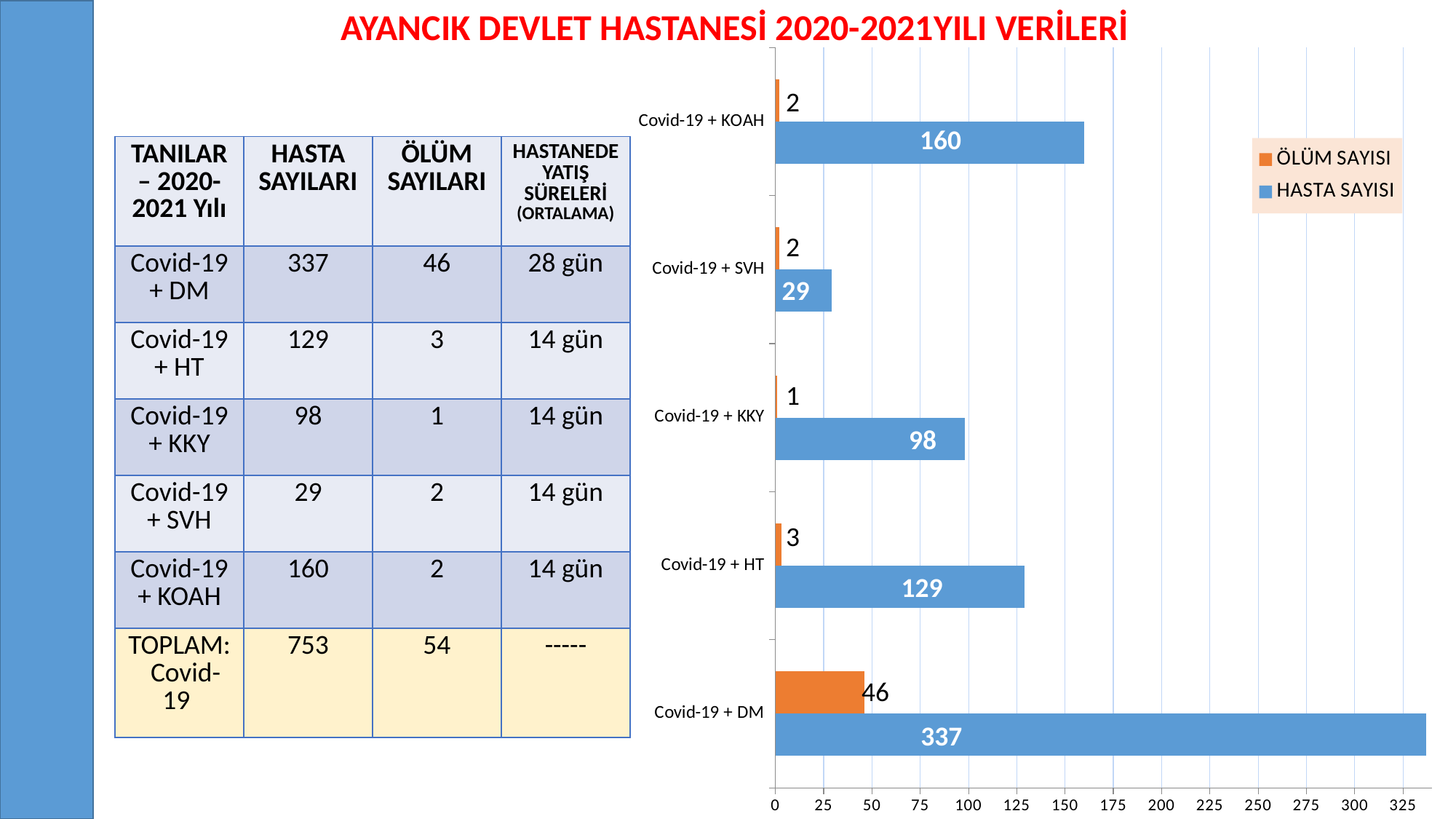
Which category has the lowest ÖLÜM SAYISI? Covid-19 + KKY Which category has the lowest HASTA SAYISI? Covid-19 + SVH What kind of chart is shown on the slide? Bar chart What is the HASTA SAYISI value for Covid-19 + SVH? 29 Which category has the highest HASTA SAYISI? Covid-19 + DM What is the difference between the HASTA SAYISI values for Covid-19 + DM and Covid-19 + KOAH? 177 Which colour represents the HASTA SAYISI series in the chart? Blue What is the HASTA SAYISI value for Covid-19 + KOAH? 160 Which is larger, the HASTA SAYISI for Covid-19 + HT or for Covid-19 + KKY? Covid-19 + HT What is the ÖLÜM SAYISI value for Covid-19 + DM? 46 How many categories are shown on the chart? 5 How many series does the legend list? 2